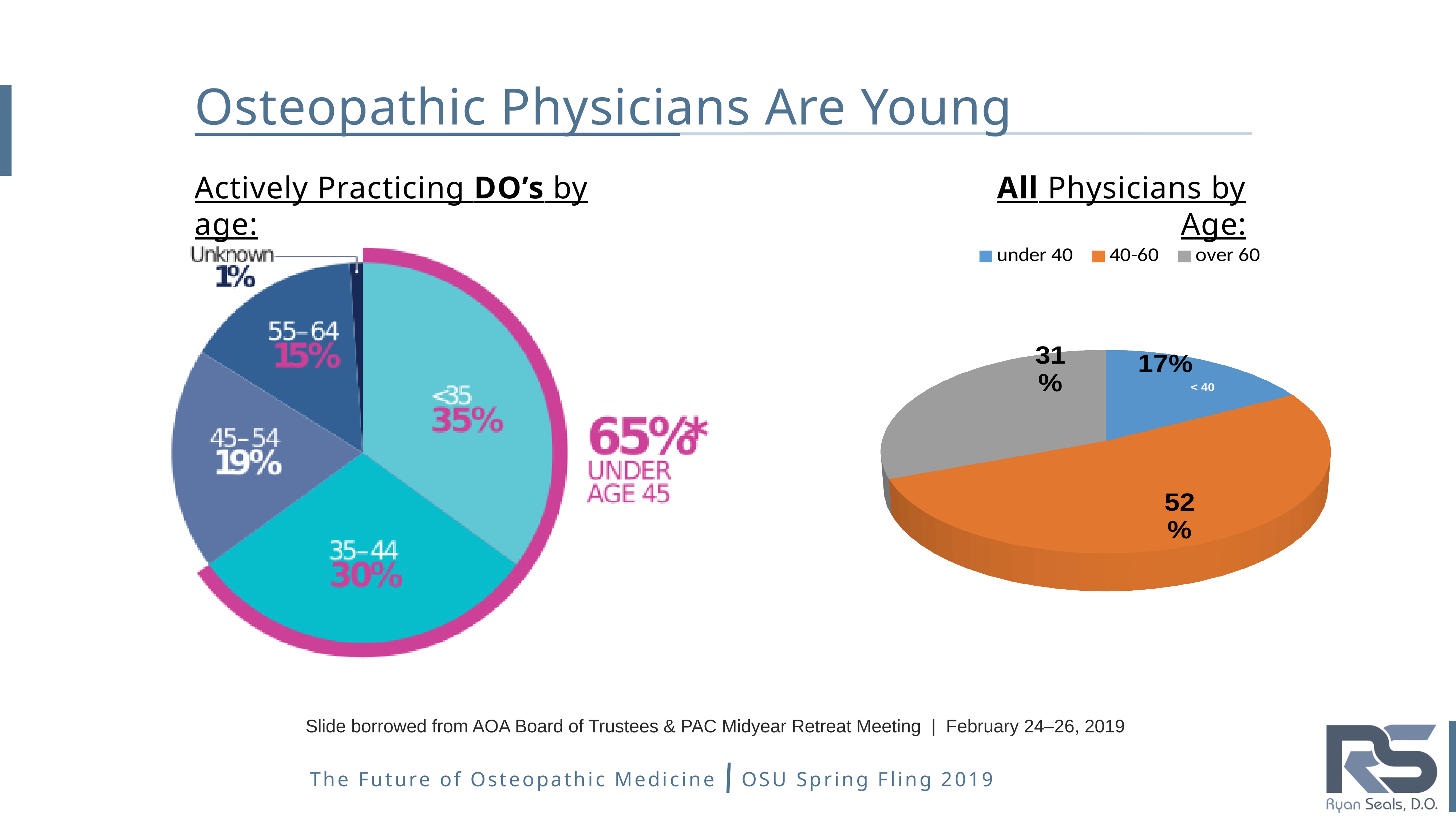
In the 'Actively Practicing DO's by age' pie chart, what share of DO's are under 35? 35% In the 'Actively Practicing DO's by age' pie chart, which age group has the smallest share? Unknown What type of chart is used for 'All Physicians by Age'? Pie chart In the 'All Physicians by Age' pie chart, what share of physicians are under 40? 17% In the 'Actively Practicing DO's by age' pie chart, which is larger: the 45-54 share or the 55-64 share? 45-54 In the 'All Physicians by Age' pie chart, what is the difference between the over 60 share and the under 40 share? 14% In the 'Actively Practicing DO's by age' pie chart, what share of DO's are aged 35-44? 30% In the 'All Physicians by Age' pie chart, which age group has the largest share? 40-60 In the 'All Physicians by Age' pie chart, which age group has the smallest share? under 40 In the 'All Physicians by Age' pie chart, how many age groups does the legend list? 3 In the 'All Physicians by Age' pie chart, what share of physicians are over 60? 31% In the 'All Physicians by Age' pie chart, what share of physicians are aged 40-60? 52%